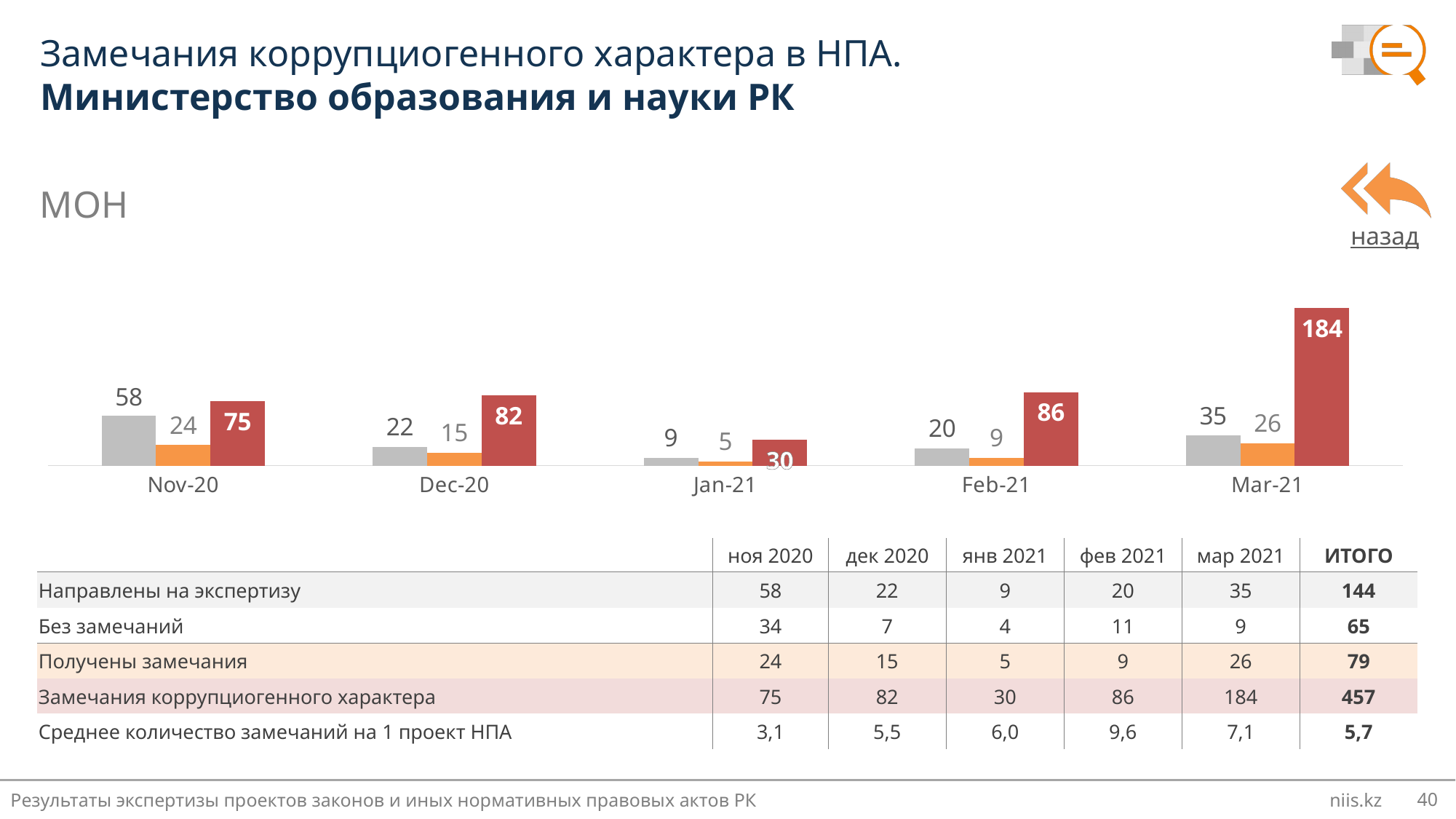
Which is larger: the gray bar for Nov-20 or the gray bar for Mar-21? Nov-20 What is the value of the orange bar (Получены замечания) for Dec-20? 15 What is the value of the red bar (Замечания коррупциогенного характера) for Mar-21? 184 In which month is the red bar (Замечания коррупциогенного характера) the highest? Mar-21 What kind of chart is shown on the slide? bar chart What is the difference between the gray bar and the orange bar for Feb-21? 11 How many months (categories) are shown on the x axis of the chart? 5 In which month is the red bar (Замечания коррупциогенного характера) the lowest? Jan-21 How many bars are shown for each month in the chart? 3 In which month is the gray bar (Направлены на экспертизу) the lowest? Jan-21 What is the difference between the red bar values for Mar-21 and Feb-21? 98 What is the value of the gray bar (Направлены на экспертизу) for Nov-20? 58